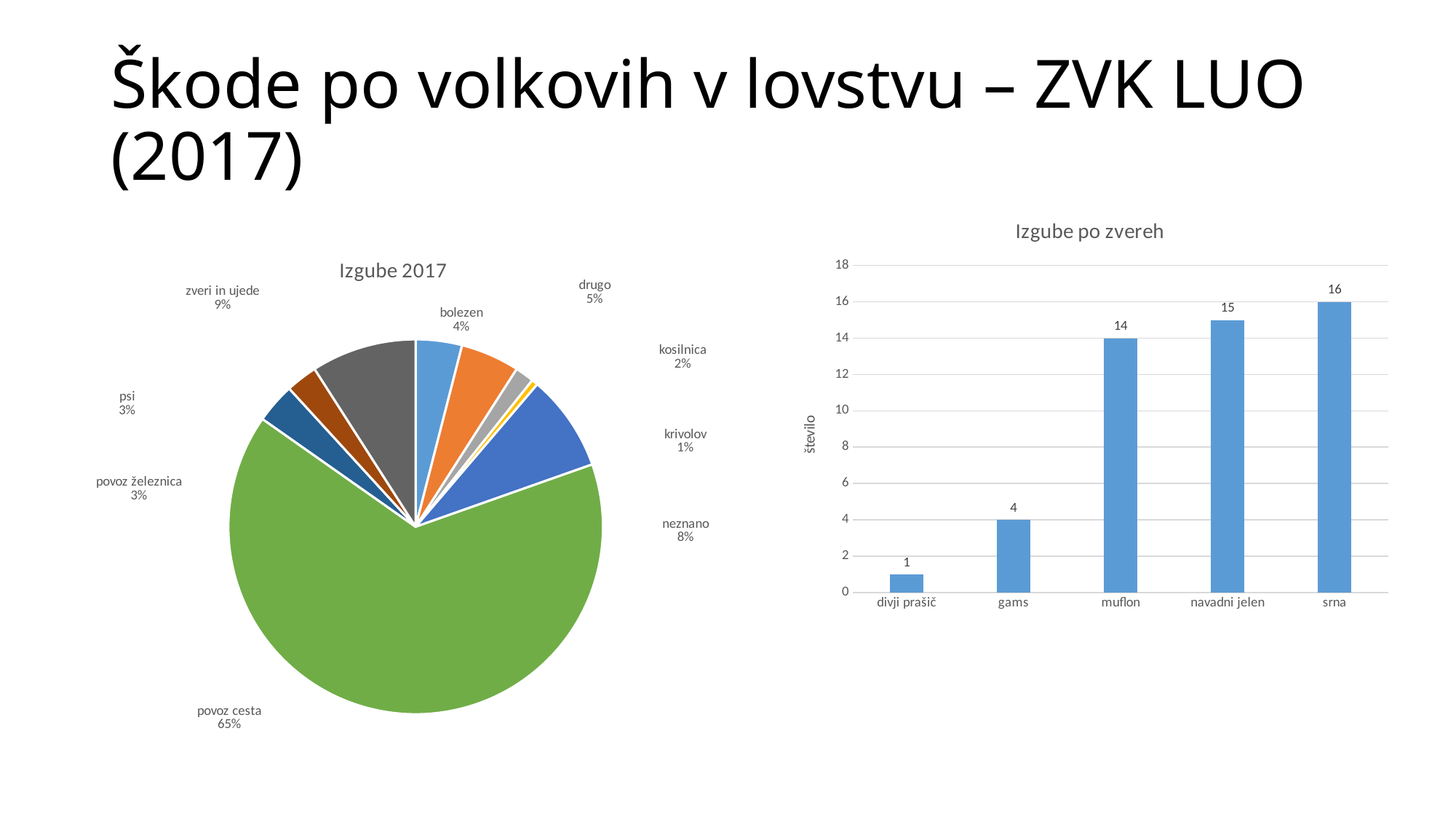
In the 'Izgube 2017' pie chart, what share does 'povoz cesta' have? 65% In the 'Izgube 2017' pie chart, which category has the smallest share? krivolov In the 'Izgube po zvereh' chart, what is the value for 'muflon'? 14 In the 'Izgube po zvereh' chart, what is the value for 'divji prašič'? 1 What kind of chart is 'Izgube po zvereh'? bar chart In the 'Izgube po zvereh' chart, what is the difference between 'srna' and 'gams'? 12 In the 'Izgube 2017' pie chart, what share does 'zveri in ujede' have? 9% In the 'Izgube 2017' pie chart, which category has the largest share? povoz cesta In the 'Izgube po zvereh' chart, which category has the highest value? srna What kind of chart is 'Izgube 2017'? pie chart In the 'Izgube 2017' pie chart, how many slices are there? 9 In the 'Izgube po zvereh' chart, which is larger, 'navadni jelen' or 'muflon'? navadni jelen